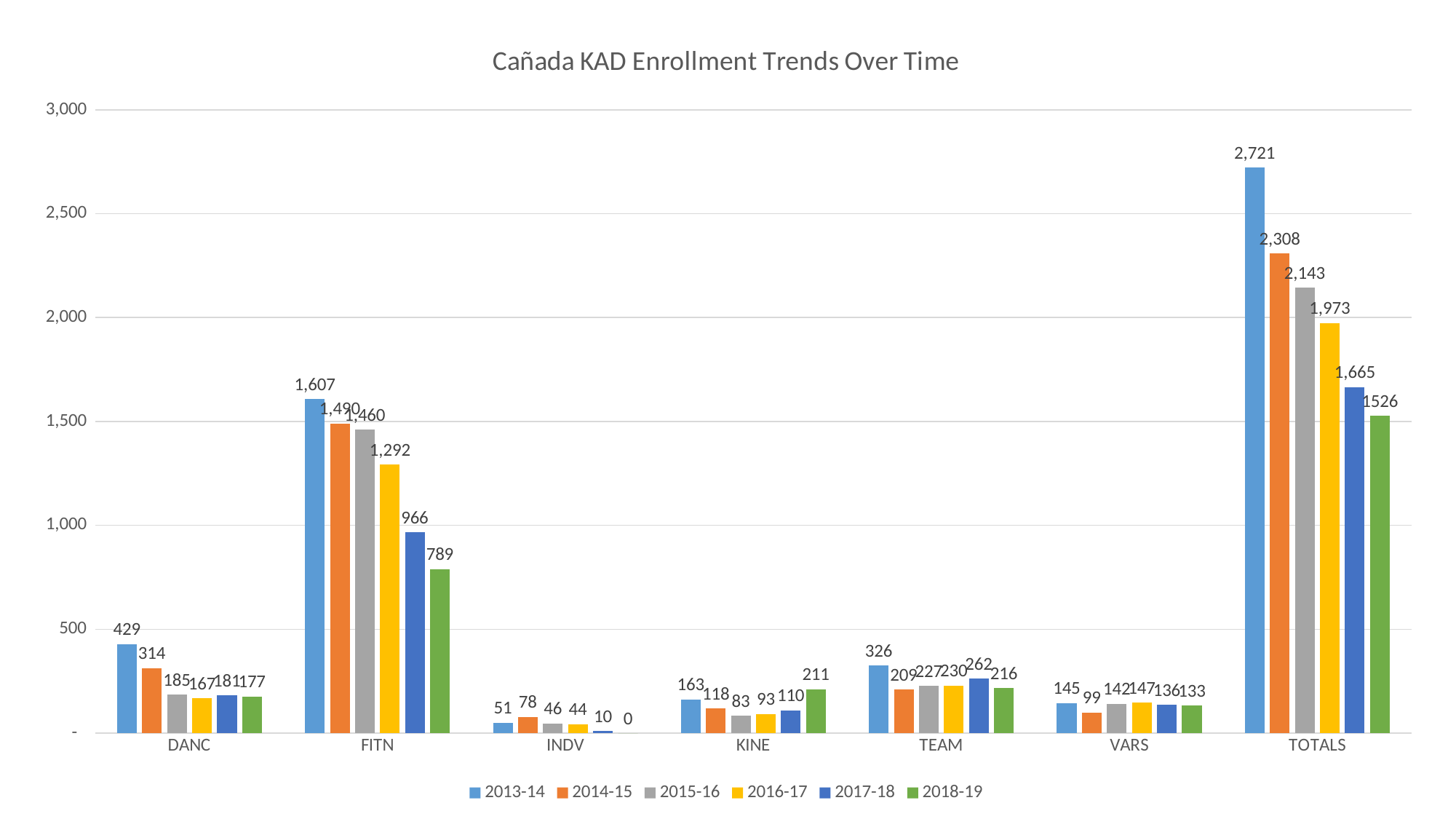
What is the INDV value for 2018-19? 0 Which is larger, the TEAM value for 2013-14 or the TEAM value for 2017-18? 2013-14 Is the FITN value for 2013-14 greater or less than 1,500? greater What is the KINE value for 2018-19? 211 How many categories are shown on the x axis? 7 What kind of chart is this? Bar chart Which year has the highest TOTALS value? 2013-14 What is the TOTALS value for 2013-14? 2,721 How many series does the legend list? 6 What is the FITN enrollment for 2018-19? 789 Which year has the lowest DANC value? 2016-17 What is the difference between the TOTALS values for 2013-14 and 2014-15? 413